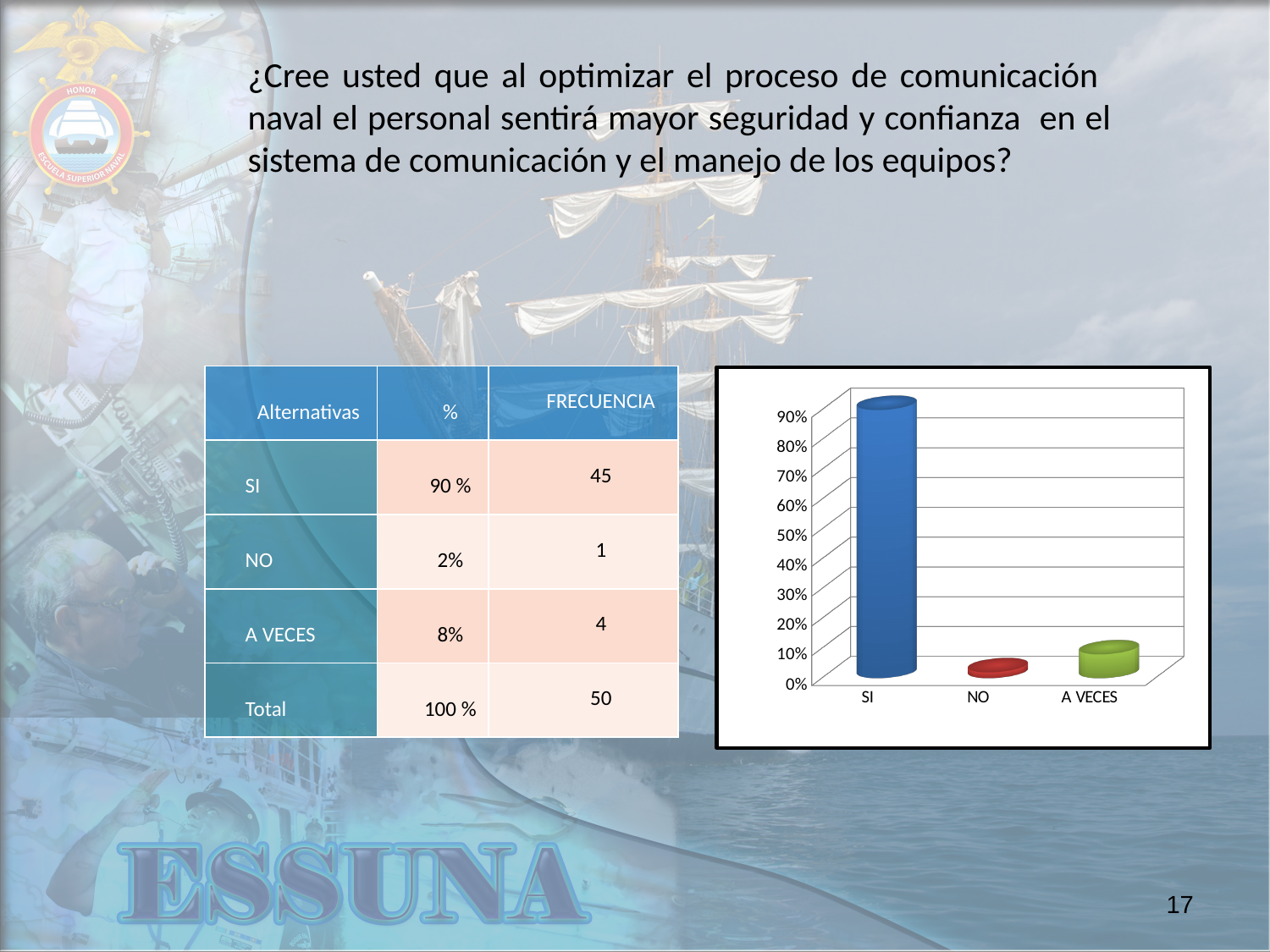
What is the highest percentage tick shown on the y axis of the chart? 90% How many categories are shown on the x axis of the chart? 3 Which category has the highest bar in the chart? SI Which is larger in the chart, the value for A VECES or the value for NO? A VECES Is the value for A VECES greater or less than 20%? less Is the value for SI greater or less than 80%? greater What kind of chart is shown on the slide? bar chart Which is larger in the chart, the value for SI or the value for A VECES? SI What colour is the bar for SI in the chart? blue Which category has the lowest bar in the chart? NO Is the value for NO greater or less than 10%? less What is the value for SI in the chart? 90%